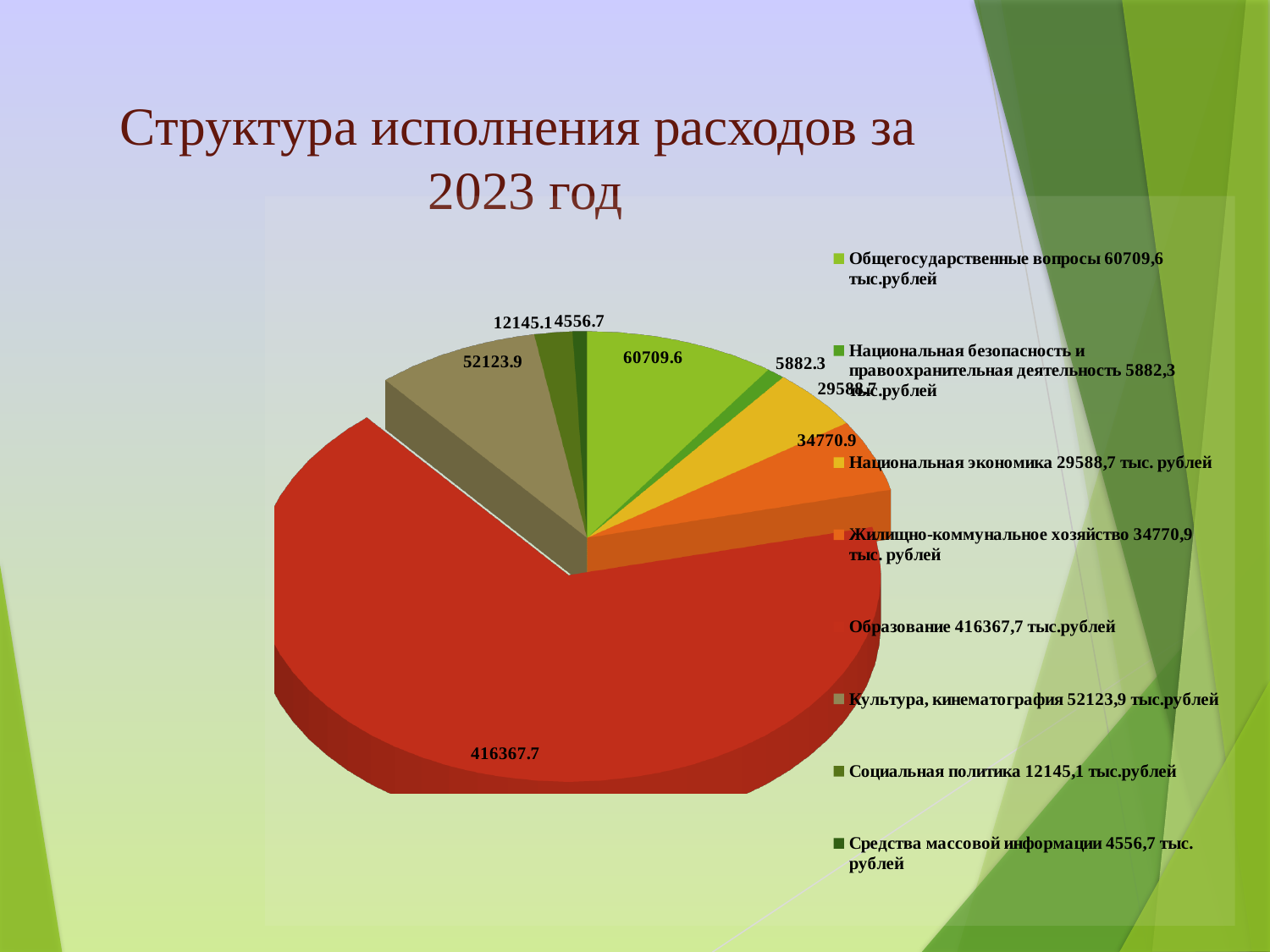
What is the value shown for Социальная политика? 12145.1 What is the value shown for Общегосударственные вопросы? 60709.6 How many slices does the pie chart have? 8 Which category has the largest slice of the pie? Образование What is the value shown for Образование? 416367.7 Which category has the smallest slice of the pie? Средства массовой информации What is the difference between the values for Жилищно-коммунальное хозяйство and Национальная экономика? 5182.2 What is the title of the slide containing the chart? Структура исполнения расходов за 2023 год What is the difference between the values for Общегосударственные вопросы and Культура, кинематография? 8585.7 What kind of chart is shown on the slide? pie chart What is the value shown for Жилищно-коммунальное хозяйство? 34770.9 Which is larger, the value for Культура, кинематография or the value for Национальная экономика? Культура, кинематография